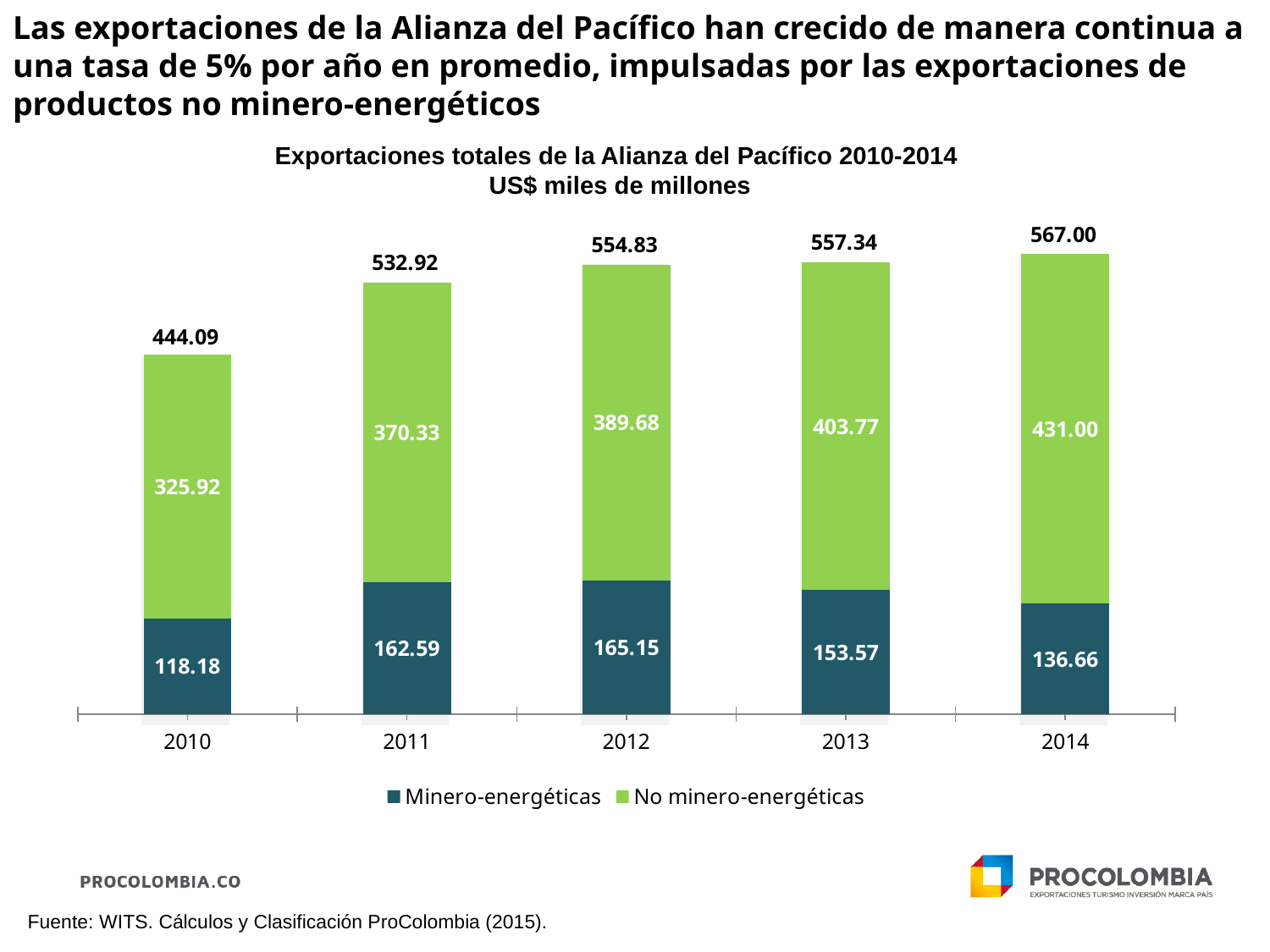
Which year has the highest total exports? 2014 What is the difference between the No minero-energéticas values for 2014 and 2013? 27.23 What kind of chart is shown? Stacked bar chart What unit is stated in the chart title? US$ miles de millones How many years are shown on the x axis? 5 What is the total of the stacked bar for 2014? 567.00 How many series does the legend list? 2 Which is larger, the Minero-energéticas value in 2011 or in 2014? 2011 What is the value for Minero-energéticas in 2012? 165.15 What is the value for No minero-energéticas in 2010? 325.92 Which year has the lowest value for Minero-energéticas? 2010 Do the total exports rise or fall from 2010 to 2014? Rise